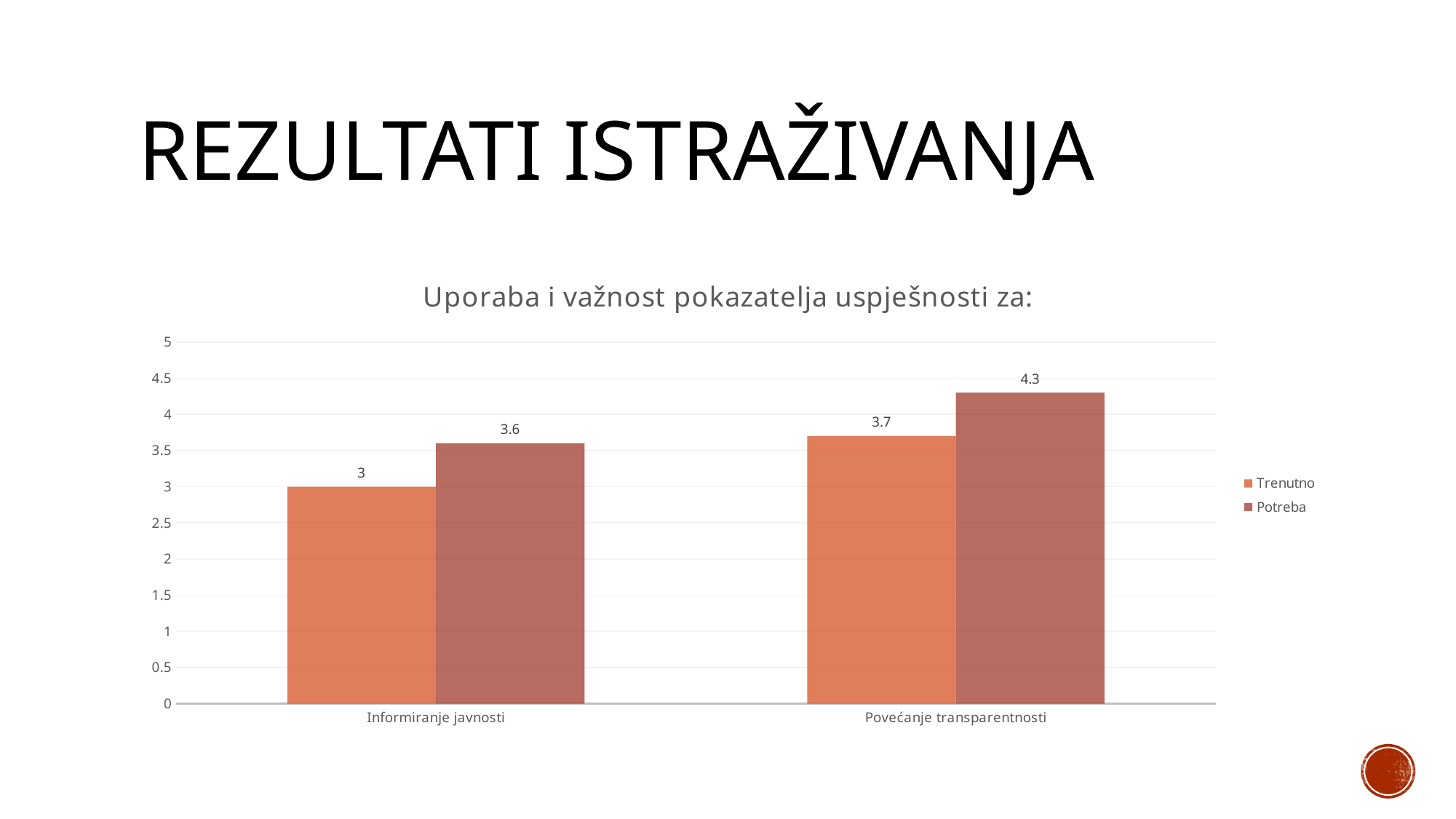
What is the difference between the Potreba and Trenutno values for Informiranje javnosti? 0.6 What is the Potreba value for Informiranje javnosti? 3.6 What is the Trenutno value for Informiranje javnosti? 3 Which category has the highest Potreba value? Povećanje transparentnosti Which category has the lowest Trenutno value? Informiranje javnosti What kind of chart is shown on the slide? Bar chart How many categories are shown on the x axis? 2 What is the Trenutno value for Povećanje transparentnosti? 3.7 What is the difference between the Potreba and Trenutno values for Povećanje transparentnosti? 0.6 What is the Potreba value for Povećanje transparentnosti? 4.3 Which is larger for Informiranje javnosti, Trenutno or Potreba? Potreba How many series does the legend list? 2